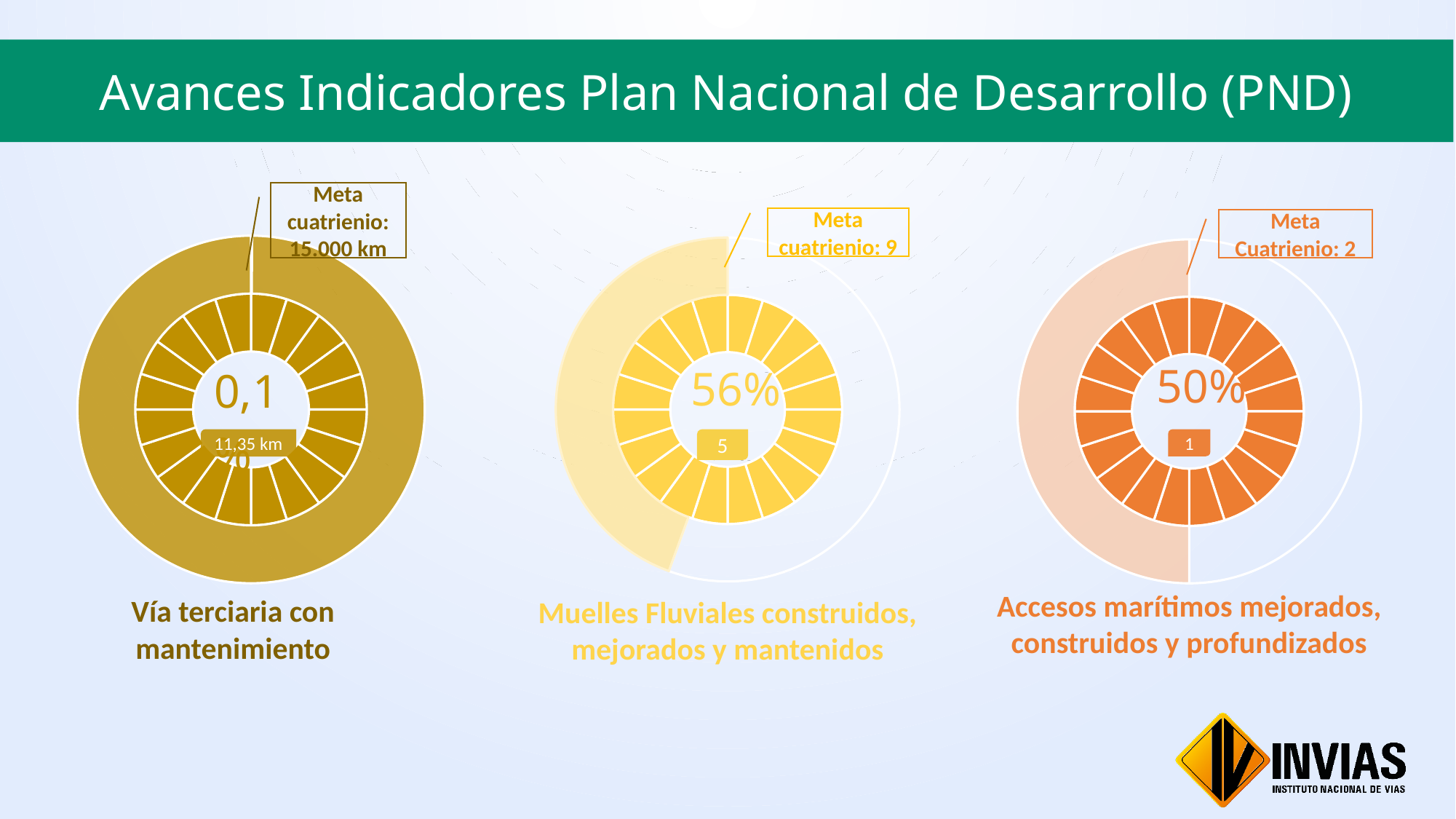
In the 'Muelles Fluviales construidos, mejorados y mantenidos' chart, how many more muelles are needed to reach the meta cuatrienio of 9? 4 What percentage is shown in the centre of the 'Accesos marítimos mejorados, construidos y profundizados' chart? 50% What is the 'Meta cuatrienio' for the 'Muelles Fluviales construidos, mejorados y mantenidos' chart? 9 What is the 'Meta cuatrienio' for the 'Vía terciaria con mantenimiento' chart? 15.000 km Which of the three charts shows the highest percentage of progress? Muelles Fluviales construidos, mejorados y mantenidos What value is shown in the centre of the 'Vía terciaria con mantenimiento' chart? 0,1 What is the 'Meta Cuatrienio' for the 'Accesos marítimos mejorados, construidos y profundizados' chart? 2 Which of the three charts shows the lowest progress value? Vía terciaria con mantenimiento What percentage is shown in the centre of the 'Muelles Fluviales construidos, mejorados y mantenidos' chart? 56% How many donut charts are shown on the slide? 3 How many muelles fluviales are shown as achieved in the 'Muelles Fluviales construidos, mejorados y mantenidos' chart? 5 How many kilometres are shown as achieved in the 'Vía terciaria con mantenimiento' chart? 11,35 km